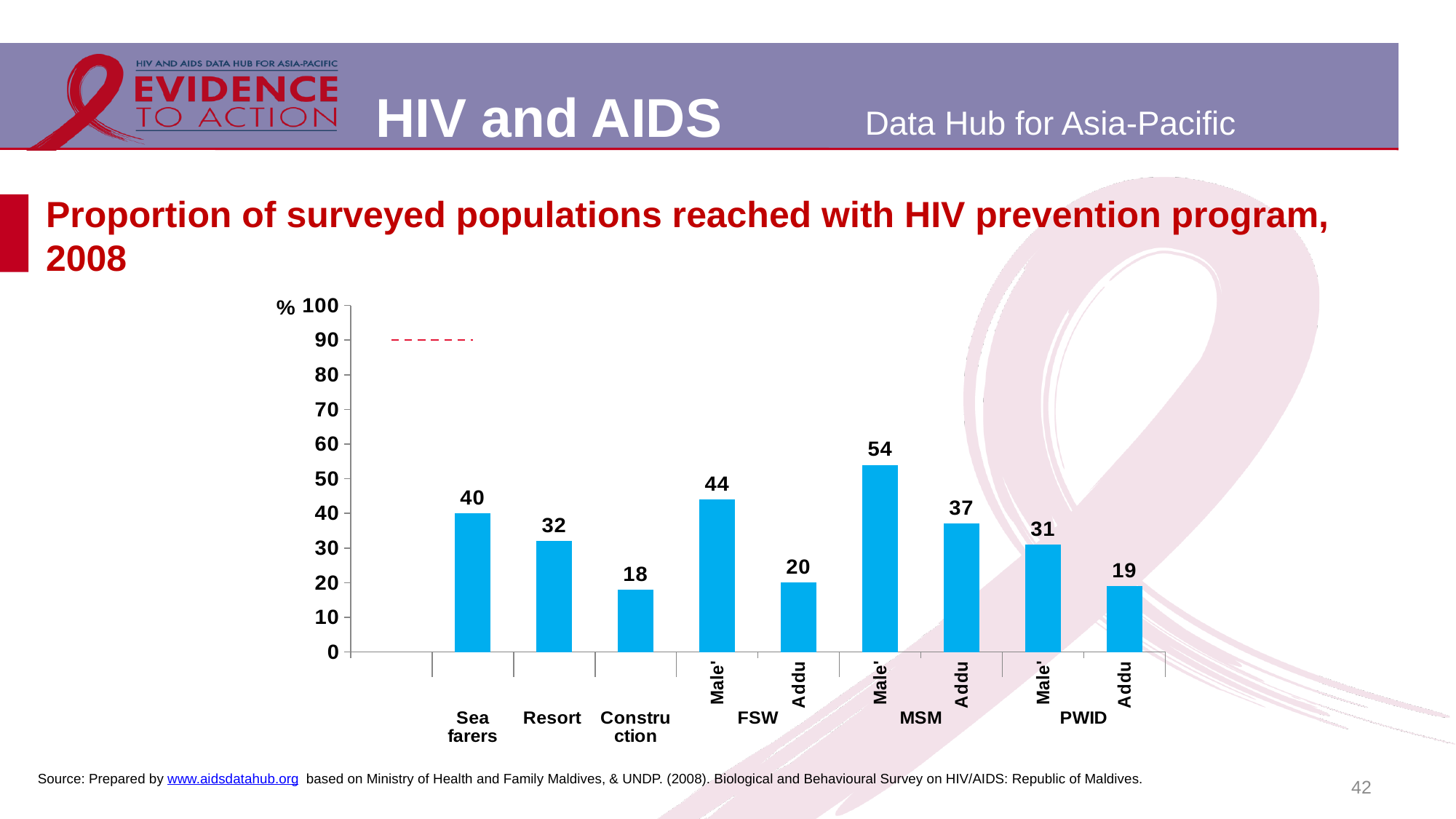
What is the value for PWID in Addu? 19 What is the difference between the FSW Male' value and the FSW Addu value? 24 What is the difference between the MSM Male' value and the MSM Addu value? 17 What is the value for FSW in Addu? 20 Which group has the highest proportion reached with the HIV prevention program? MSM Male' What is the value for Sea farers? 40 What is the maximum value shown on the y axis? 100 What is the value for MSM in Male'? 54 How many bars are plotted in the chart? 9 Which group has the lowest proportion reached with the HIV prevention program? Construction What type of chart is shown on the slide? Bar chart Which is larger, the value for Resort or the value for PWID Male'? Resort